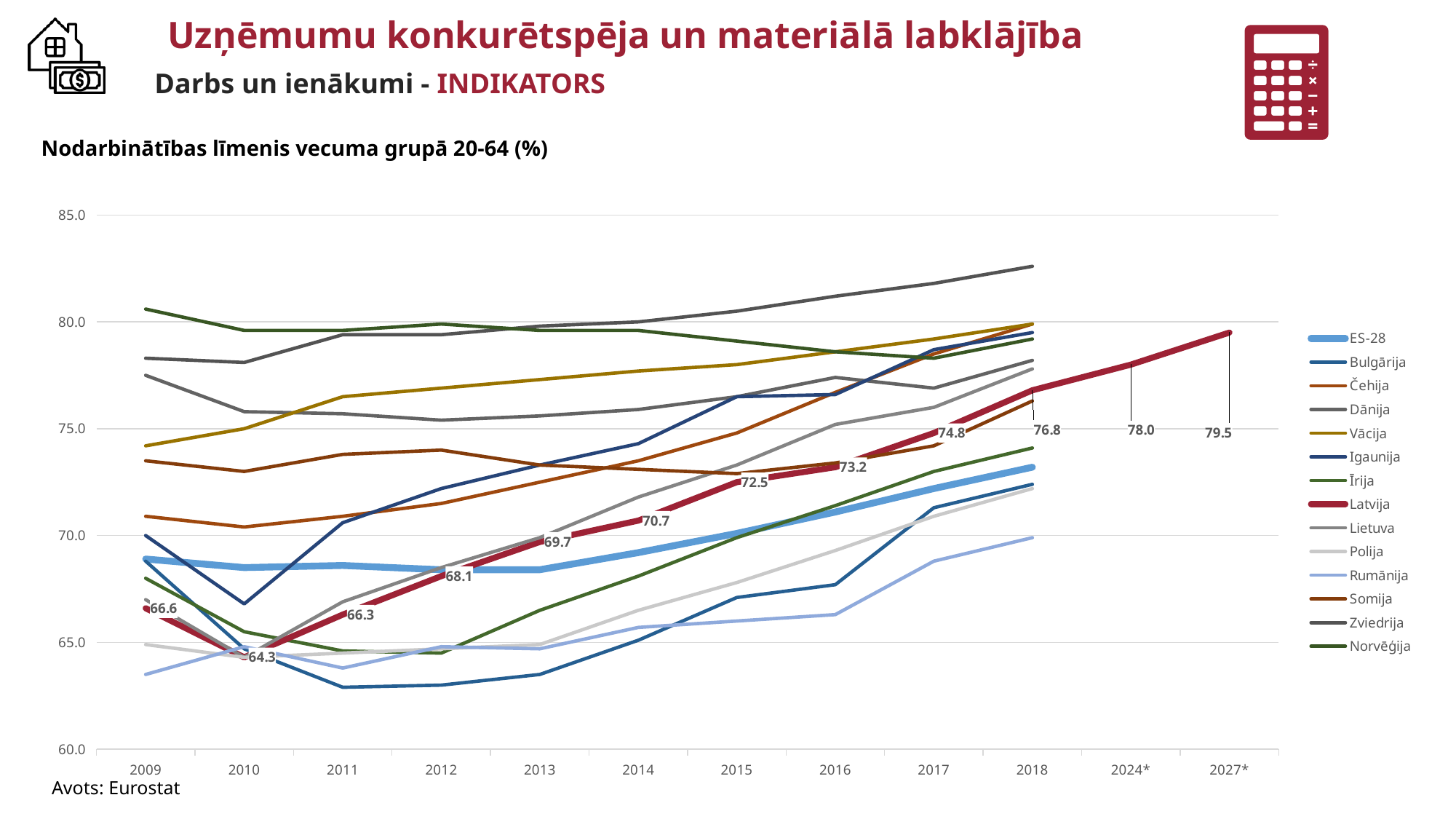
How many points are on the x axis? 12 What is the value for Latvija in 2018? 76.8 What is the difference between the Latvija values for 2027* and 2018? 2.7 What is the value for Latvija in 2010? 64.3 In which year is the Latvija value lowest? 2010 Is the value for Zviedrija in 2018 greater or less than 80.0? greater Is the value for Bulgārija in 2011 greater or less than 65.0? less What kind of chart is shown? line chart In which year is the Latvija value highest? 2027* Which is larger for Latvija: the value in 2017 or the value in 2018? 2018 What is the value for Latvija in 2027*? 79.5 How many series does the legend list? 14